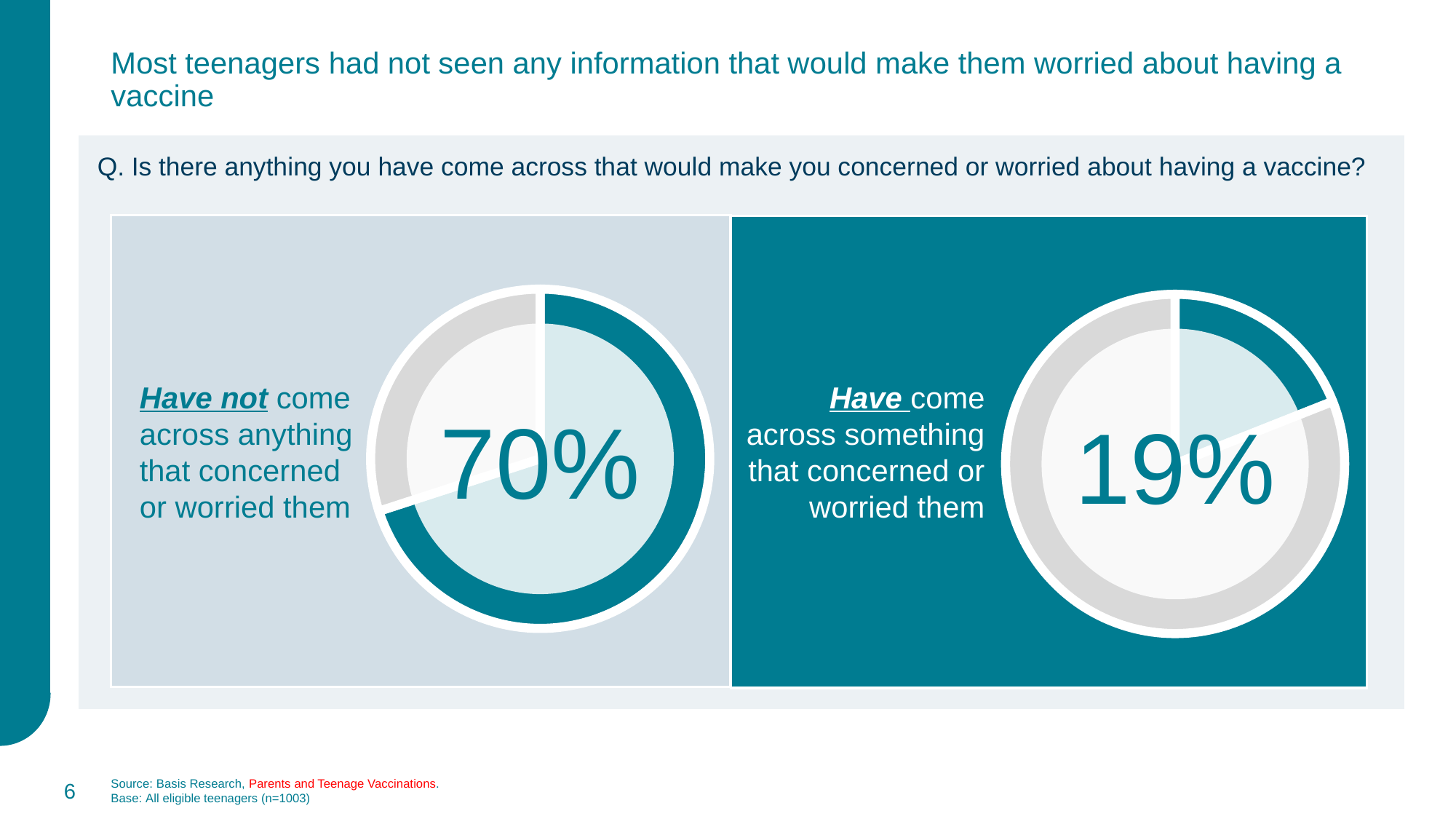
Which is larger: the share of teenagers who have not come across anything concerning (left chart) or the share who have (right chart)? Have not come across anything (70%) How many charts are shown on the slide? 2 On the left chart, what percentage of teenagers had not come across anything that concerned or worried them about having a vaccine? 70% On the left chart, is the value for teenagers who have not come across anything concerning greater or less than 50%? greater What survey question do the two charts on the slide relate to? Is there anything you have come across that would make you concerned or worried about having a vaccine? On the right chart, what percentage of teenagers had come across something that concerned or worried them about having a vaccine? 19% What is the difference in percentage points between the left chart value (70%) and the right chart value (19%)? 51 percentage points On the right chart, is the value for teenagers who have come across something concerning greater or less than 25%? less What kind of chart is used on the left side of the slide to show the 70% figure? Pie (donut) chart What is the base (sample size) stated for the charts on the slide? All eligible teenagers (n=1003)